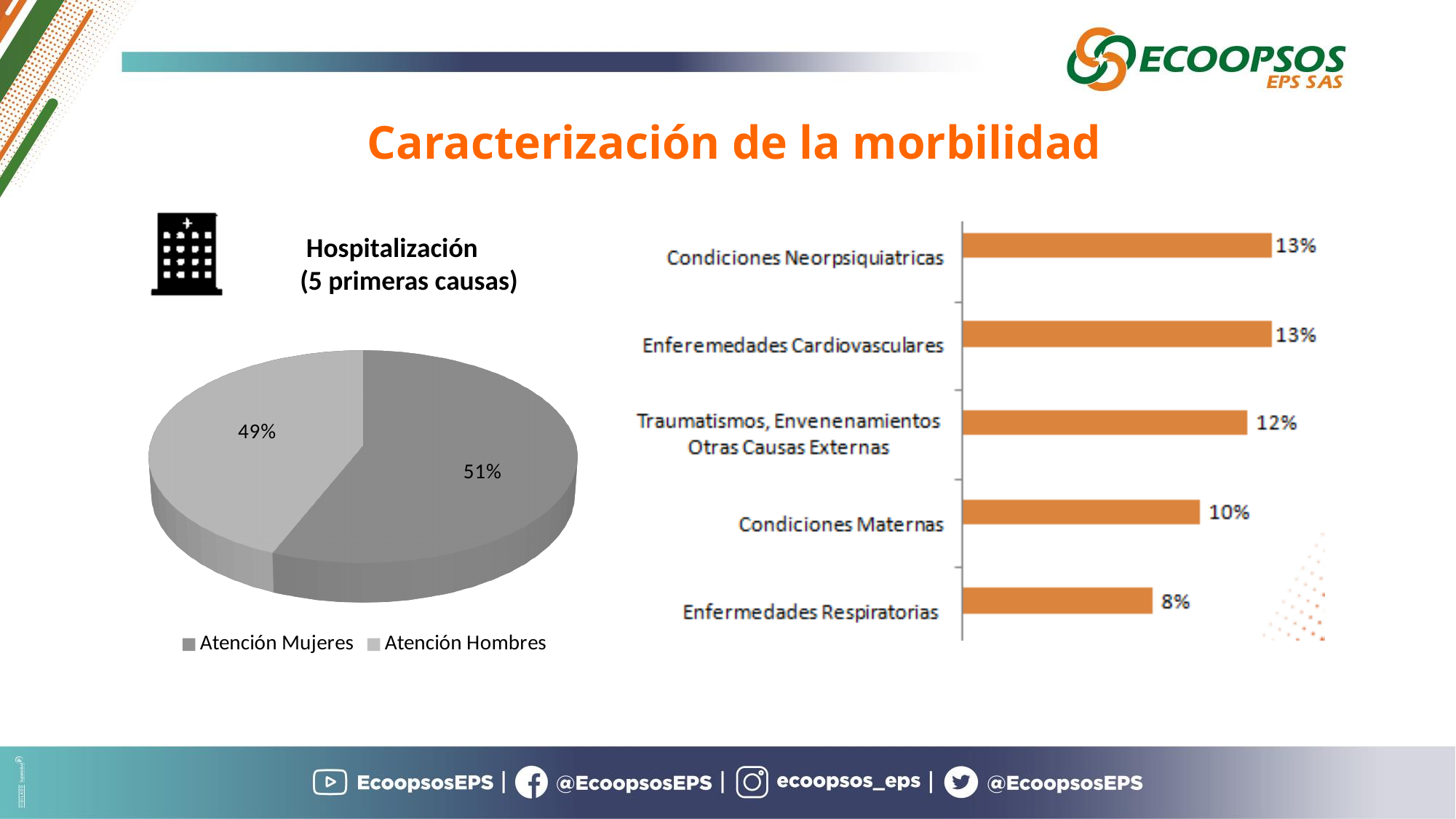
What kind of chart is the chart on the left of the slide? Pie chart In the pie chart on the left, which slice is larger, Atención Mujeres or Atención Hombres? Atención Mujeres In the bar chart on the right, what is the value for Condiciones Maternas? 10% In the bar chart on the right, which category has the lowest value? Enfermedades Respiratorias In the pie chart on the left, what share is labelled for Atención Mujeres? 51% How many entries does the legend of the pie chart on the left list? 2 In the bar chart on the right, which is larger, Traumatismos, Envenenamientos Otras Causas Externas or Condiciones Maternas? Traumatismos, Envenenamientos Otras Causas Externas In the bar chart on the right, what is the difference between Condiciones Neorpsiquiatricas and Enfermedades Respiratorias? 5% In the bar chart on the right, what is the value for Enfermedades Respiratorias? 8% How many categories does the bar chart on the right show? 5 What kind of chart is the chart on the right of the slide? Bar chart In the pie chart on the left, what share is labelled for Atención Hombres? 49%